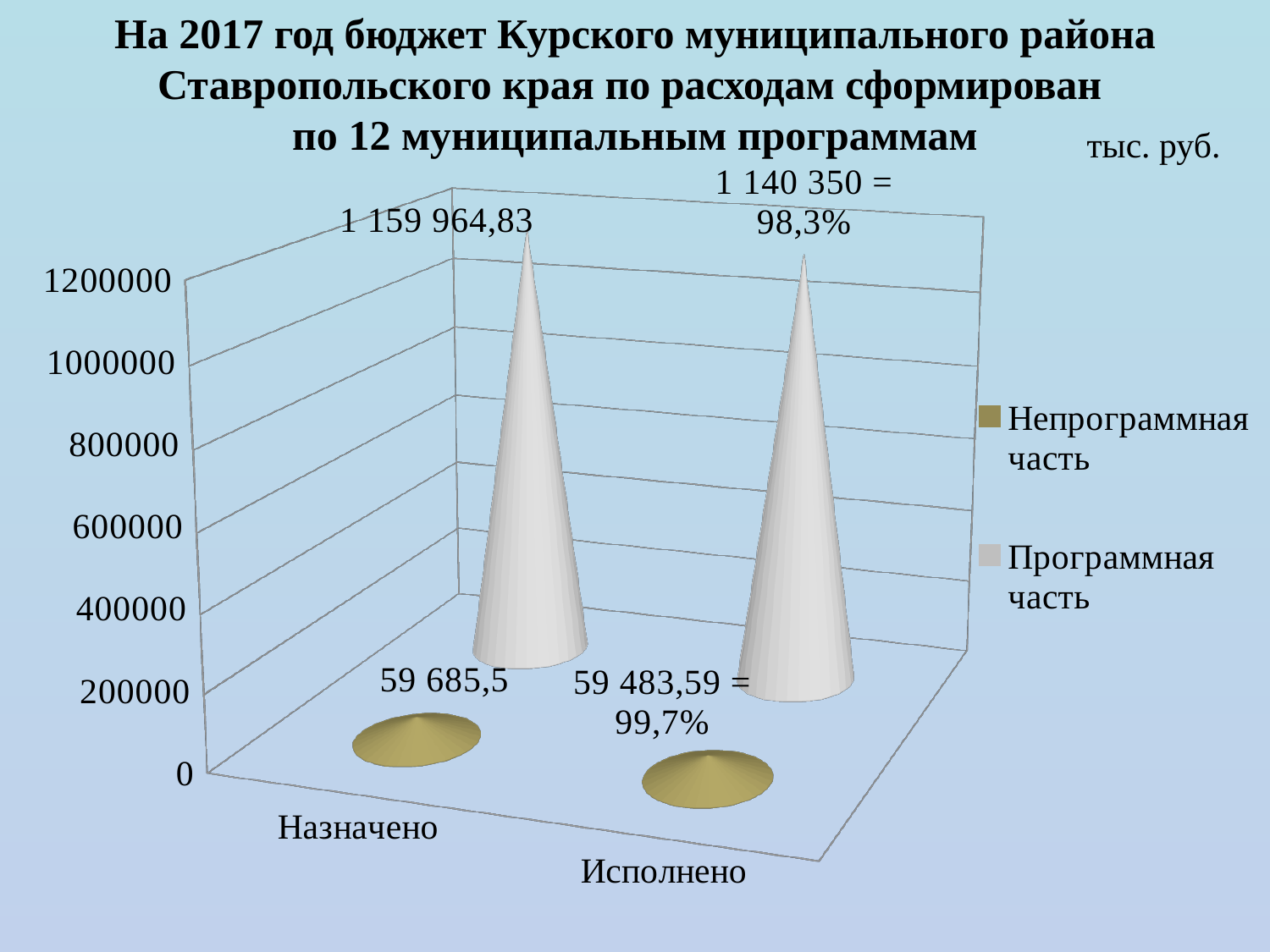
What percentage is shown next to the Исполнено value of Непрограммная часть? 99,7% What is the value of Непрограммная часть for Исполнено? 59 483,59 What unit of measurement is indicated on the slide for the chart values? тыс. руб. What is the value of Непрограммная часть for Назначено? 59 685,5 How many categories are shown on the x axis? 2 How many series does the legend list? 2 What is the difference between the Назначено and Исполнено values of Непрограммная часть? 201,91 What percentage is shown next to the Исполнено value of Программная часть? 98,3% What is the value of Программная часть for Назначено? 1 159 964,83 What is the value of Программная часть for Исполнено? 1 140 350 Which series has the higher value for Назначено, Программная часть or Непрограммная часть? Программная часть What is the difference between the Назначено and Исполнено values of Программная часть? 19 614,83